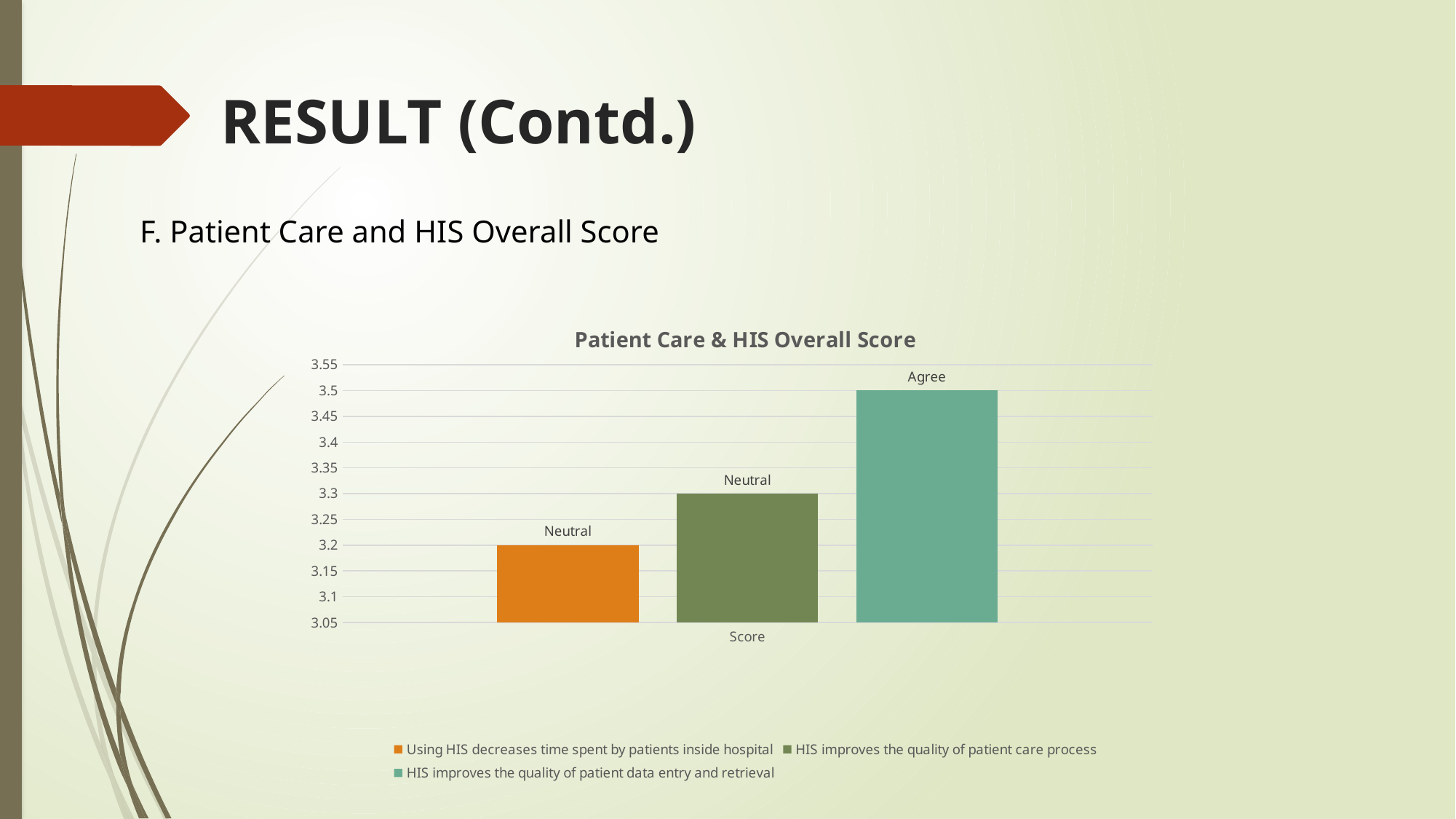
What is the value for 'HIS improves the quality of patient data entry and retrieval'? 3.5 How many series does the legend list? 3 What is the title of the chart? Patient Care & HIS Overall Score Which series has the lowest value? Using HIS decreases time spent by patients inside hospital Which is larger: the value for 'HIS improves the quality of patient care process' or the value for 'Using HIS decreases time spent by patients inside hospital'? HIS improves the quality of patient care process What is the difference between the values for 'HIS improves the quality of patient data entry and retrieval' and 'Using HIS decreases time spent by patients inside hospital'? 0.3 What data label is shown above the bar for 'HIS improves the quality of patient data entry and retrieval'? Agree What is the value for 'Using HIS decreases time spent by patients inside hospital'? 3.2 What is the value for 'HIS improves the quality of patient care process'? 3.3 What is the category label shown on the x axis? Score What type of chart is shown on the slide? Bar chart Which series has the highest value? HIS improves the quality of patient data entry and retrieval